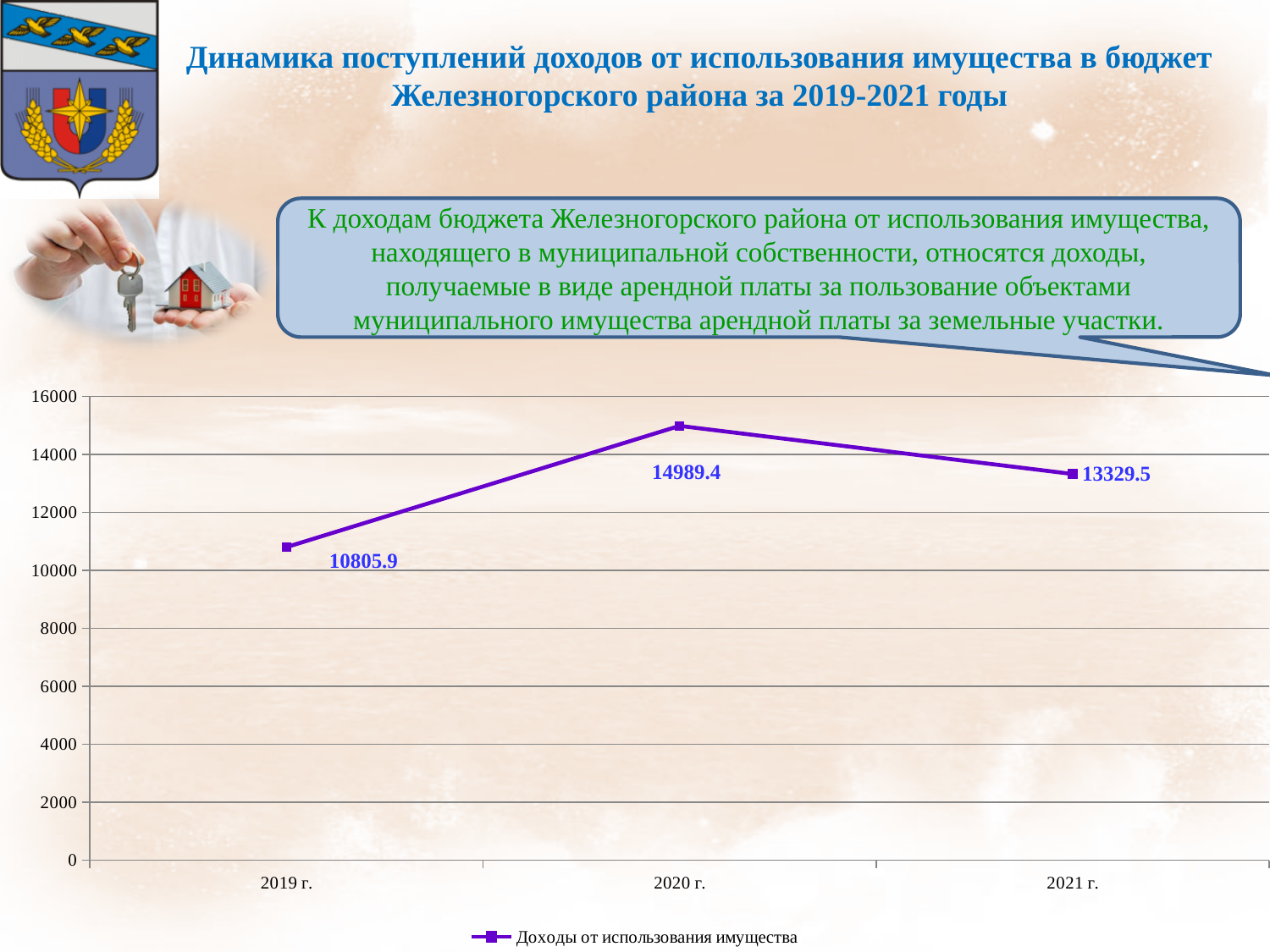
What kind of chart is shown on the slide? line chart What is the legend entry for the plotted series? Доходы от использования имущества What is the value for 2019 г.? 10805.9 Is the value for 2019 г. greater or less than 12000? less What is the difference between the values for 2020 г. and 2019 г.? 4183.5 Which is larger, the value for 2021 г. or the value for 2019 г.? 2021 г. What is the value for 2021 г.? 13329.5 What is the difference between the values for 2020 г. and 2021 г.? 1659.9 Which year has the highest value? 2020 г. What is the value for 2020 г.? 14989.4 Which year has the lowest value? 2019 г. How many years are plotted on the chart? 3